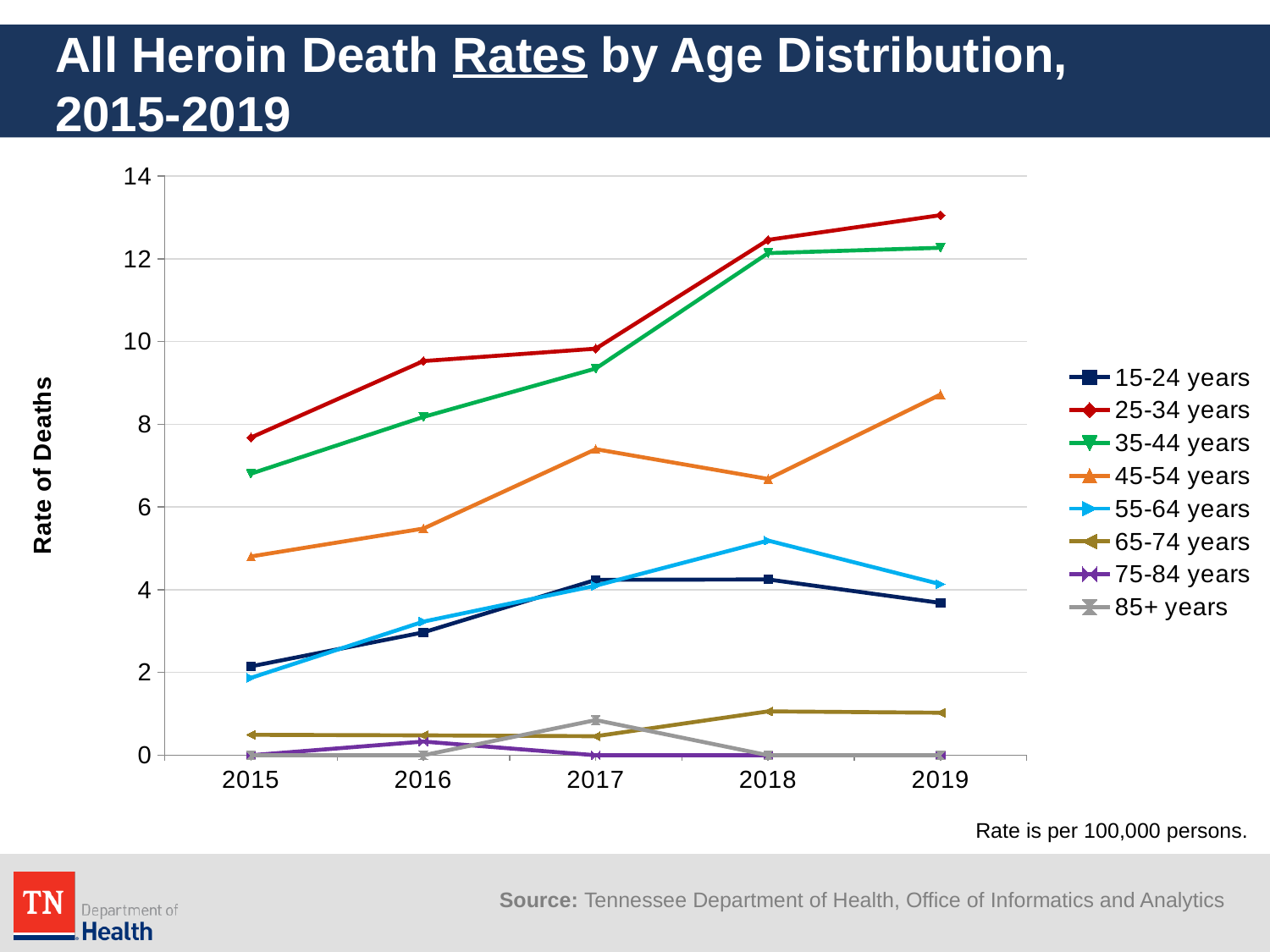
How many age groups does the legend list? 8 Is the value for 25-34 years in 2019 greater or less than 12? greater Which age group has the highest heroin death rate in 2015? 25-34 years Which age group has the highest heroin death rate in 2019? 25-34 years In 2018, which has the larger rate: 45-54 years or 55-64 years? 45-54 years How many years are shown along the x axis? 5 Which age group has the lowest heroin death rate in 2017? 75-84 years Is the value for 55-64 years in 2018 greater or less than 4? greater Is the value for 15-24 years in 2015 greater or less than 4? less Does the rate for 35-44 years rise or fall from 2015 to 2019? rise What is the label on the y axis? Rate of Deaths What kind of chart is shown on the slide? line chart